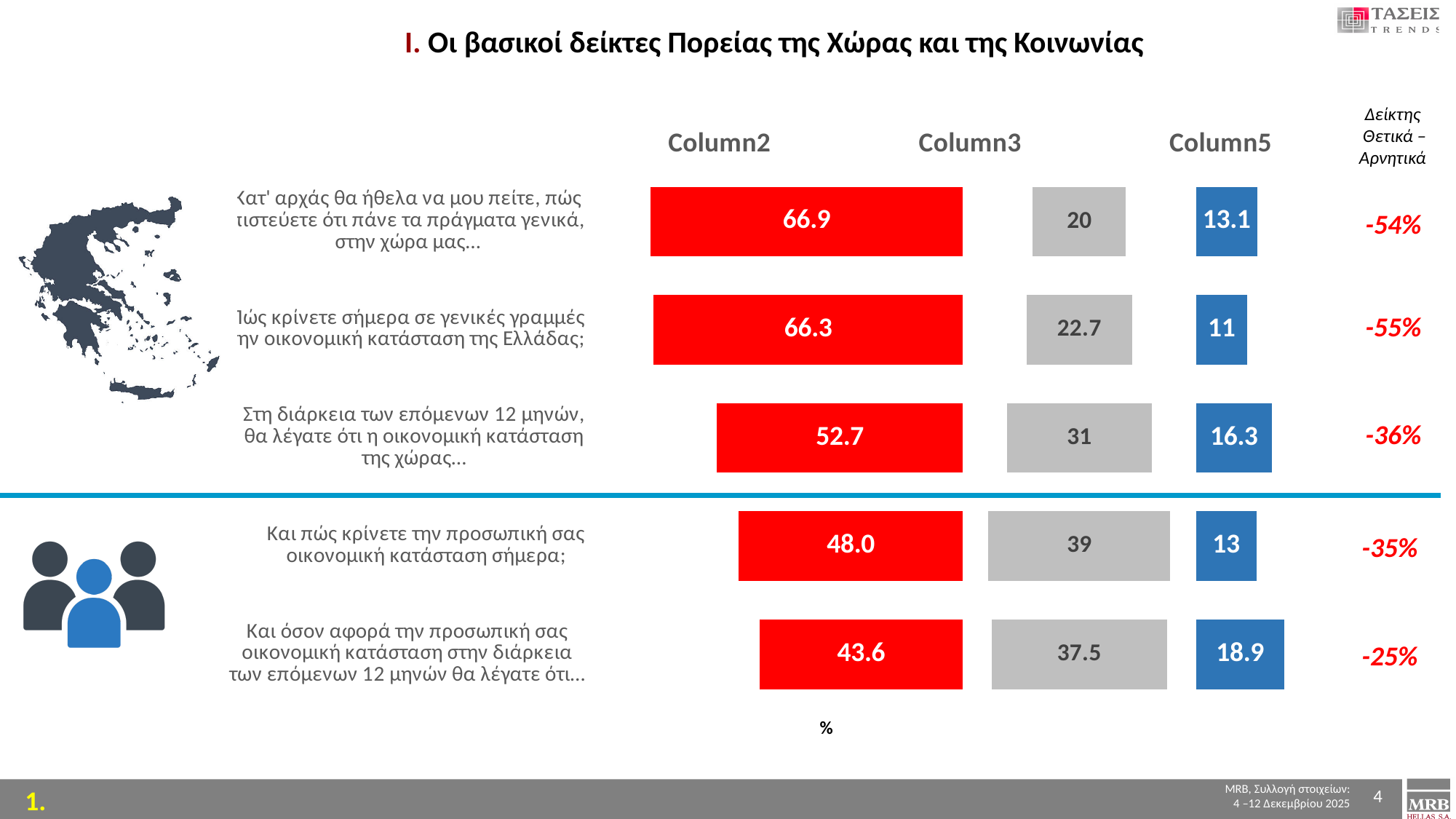
What is the Column2 value for the row 'Πώς κρίνετε σήμερα σε γενικές γραμμές την οικονομική κατάσταση της Ελλάδας;'? 66.3 How many question rows (categories) are plotted in the chart? 5 Which row has the lowest Column5 value? Πώς κρίνετε σήμερα σε γενικές γραμμές την οικονομική κατάσταση της Ελλάδας; (11) What is the difference between the Column2 value of the first row (66.9) and the Column2 value of the last row (43.6)? 23.3 How many series does the chart show (Column2, Column3, Column5)? 3 What kind of chart is shown on the slide? bar chart What is the Column5 value for the row 'Στη διάρκεια των επόμενων 12 μηνών, θα λέγατε ότι η οικονομική κατάσταση της χώρας...'? 16.3 What is the 'Δείκτης Θετικά – Αρνητικά' value shown for the first row? -54% What is the total of the stacked bar for the last row (43.6 + 37.5 + 18.9)? 100 Which row has the highest Column2 value? Κατ' αρχάς θα ήθελα να μου πείτε, πώς πιστεύετε ότι πάνε τα πράγματα γενικά, στην χώρα μας... (66.9) What is the Column3 value for the row 'Και πώς κρίνετε την προσωπική σας οικονομική κατάσταση σήμερα;'? 39 Which is larger: the Column2 value for 'Στη διάρκεια των επόμενων 12 μηνών, θα λέγατε ότι η οικονομική κατάσταση της χώρας...' or for 'Και πώς κρίνετε την προσωπική σας οικονομική κατάσταση σήμερα;'? Στη διάρκεια των επόμενων 12 μηνών, θα λέγατε ότι η οικονομική κατάσταση της χώρας... (52.7)